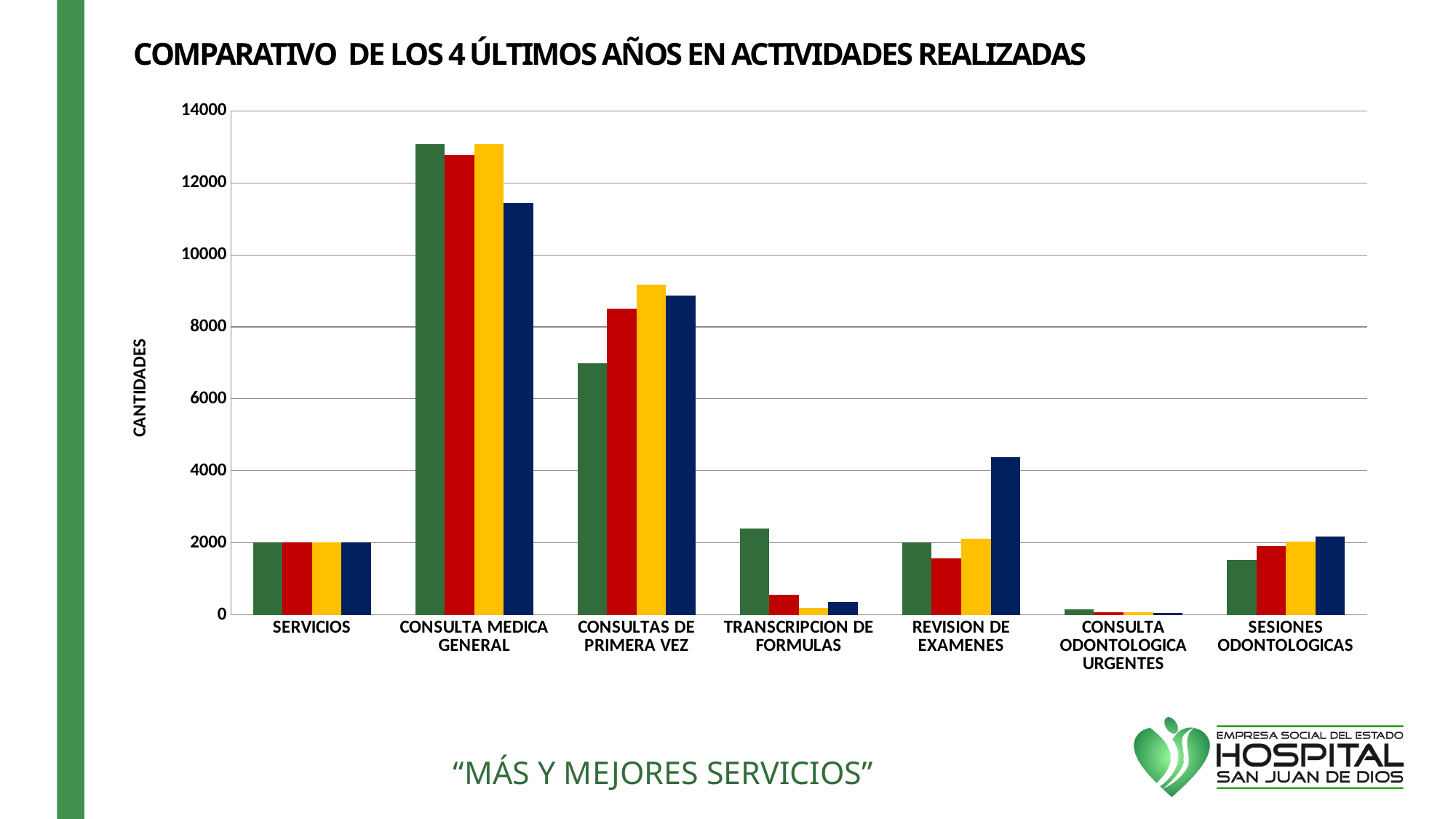
For REVISION DE EXAMENES, which is larger: the green bar or the dark blue bar? the dark blue bar What is the label of the vertical axis of the chart? CANTIDADES Which category has the lowest bars in the chart? CONSULTA ODONTOLOGICA URGENTES For TRANSCRIPCION DE FORMULAS, which is larger: the green bar or the red bar? the green bar What kind of chart is shown on the slide? bar chart Is the value of the green bar for CONSULTA MEDICA GENERAL greater or less than 12000? greater Is the value of the dark blue bar for REVISION DE EXAMENES greater or less than 4000? greater Is the value of the green bar for CONSULTAS DE PRIMERA VEZ greater or less than 8000? less Which category has the tallest bars in the chart? CONSULTA MEDICA GENERAL How many bars are plotted for each category in the chart? 4 How many categories are shown on the x axis of the chart? 7